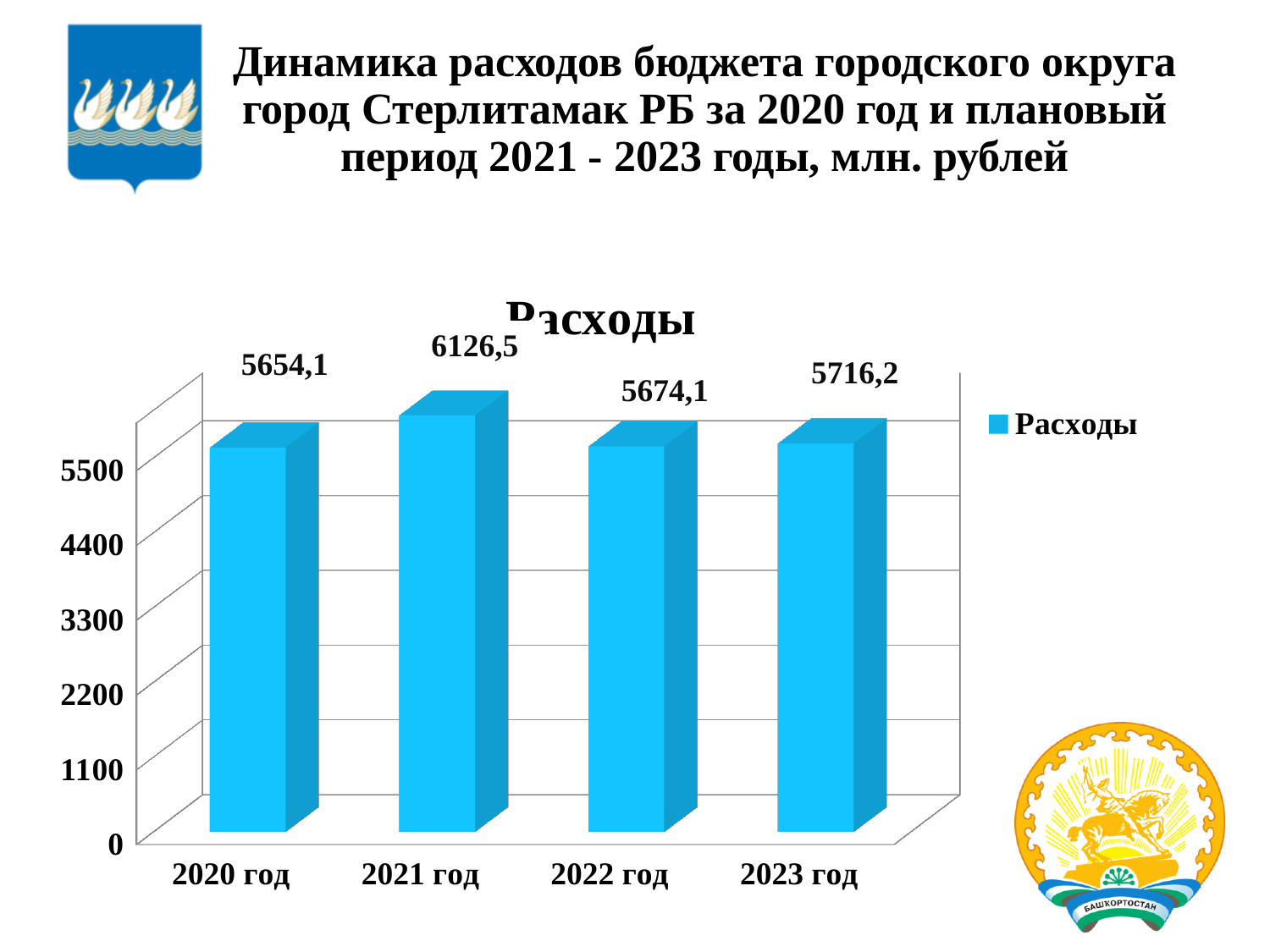
Which is larger, the value for 2021 год or the value for 2023 год? 2021 год What is the value for 2023 год in the Расходы chart? 5716,2 How many years are shown on the x axis of the chart? 4 What is the value for 2021 год in the Расходы chart? 6126,5 Which year has the lowest value in the Расходы chart? 2020 год Which year has the highest value in the Расходы chart? 2021 год How many series does the legend list? 1 What is the value for 2020 год in the Расходы chart? 5654,1 What kind of chart is shown on the slide? bar chart What is the value for 2022 год in the Расходы chart? 5674,1 What is the difference between the values for 2023 год and 2022 год? 42,1 What is the difference between the values for 2021 год and 2020 год? 472,4